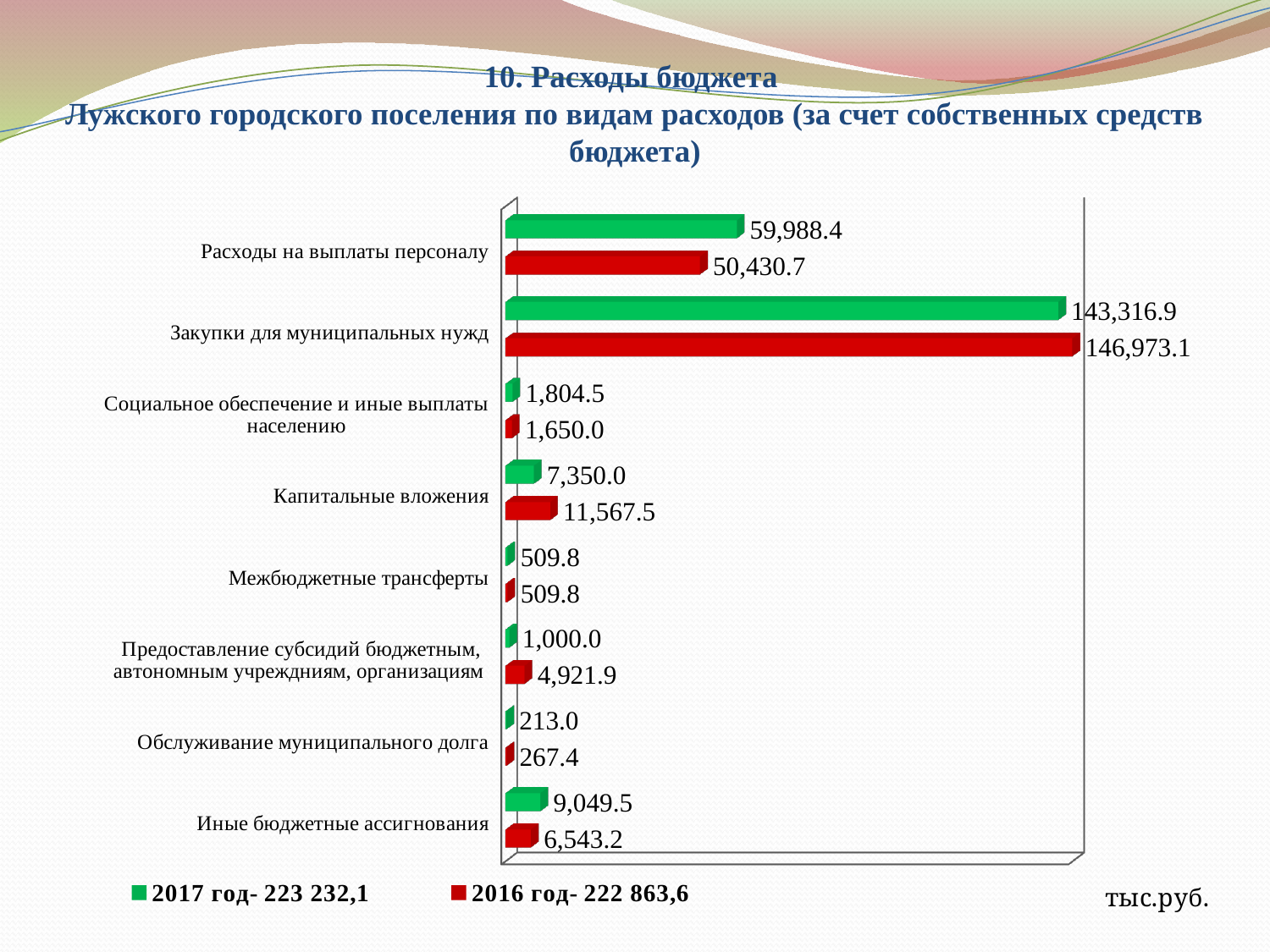
For Иные бюджетные ассигнования, which year has the larger value, 2017 or 2016? 2017 What is the difference between the 2017 and 2016 values for Расходы на выплаты персоналу? 9,557.7 What is the 2016 value for Закупки для муниципальных нужд? 146,973.1 What is the 2017 value for Расходы на выплаты персоналу? 59,988.4 How many series does the legend list? 2 Which category has the highest 2017 value? Закупки для муниципальных нужд Which category has the lowest 2016 value? Обслуживание муниципального долга What is the difference between the 2016 and 2017 values for Капитальные вложения? 4,217.5 How many expense categories are shown in the chart? 8 What type of chart is shown on the slide? Bar chart What is the 2017 value for Обслуживание муниципального долга? 213.0 What is the 2016 value for Капитальные вложения? 11,567.5